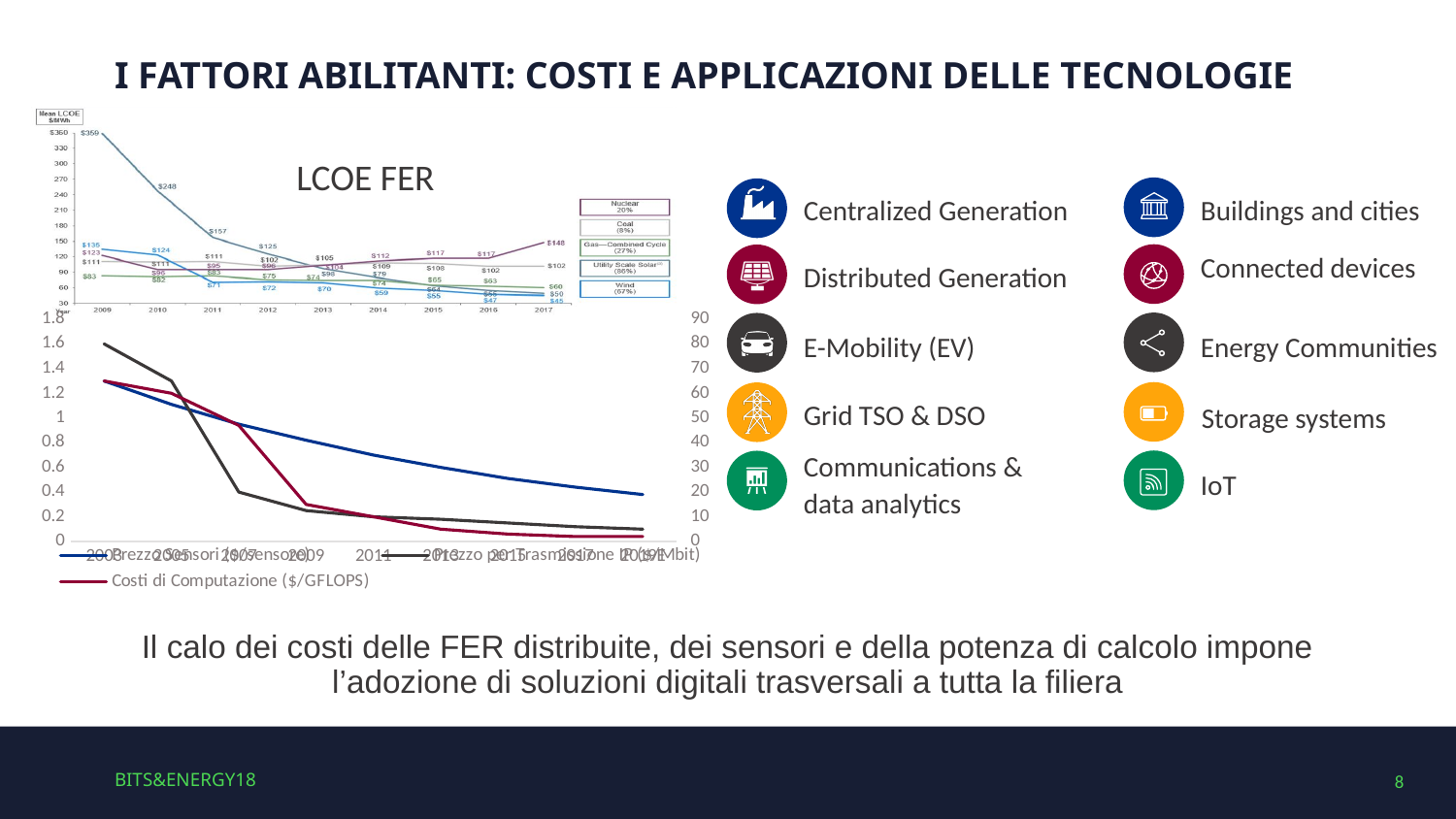
In the lower-left line chart, what is the legend label of the red series? Costi di Computazione ($/GFLOPS) In the lower-left line chart, is the value of the Prezzo Sensori (€/Sensore) series in 2003 greater or less than 1.4? less In the LCOE FER chart, what is the value labelled for the top line in 2010? $248 In the lower-left line chart, do the values of the Prezzo Sensori series rise or fall from 2003 to 2017? Fall What is the title shown on the upper-left chart? LCOE FER In the lower-left line chart, is the value of the Prezzo Sensori (€/Sensore) series in 2017 greater or less than 0.2? greater What kind of chart is the lower-left chart with the legend entries Prezzo Sensori, Prezzo per Trasmissione and Costi di Computazione? Line chart In the LCOE FER chart, what is the highest value labelled for the year 2009? $359 How many series does the legend of the lower-left line chart list? 3